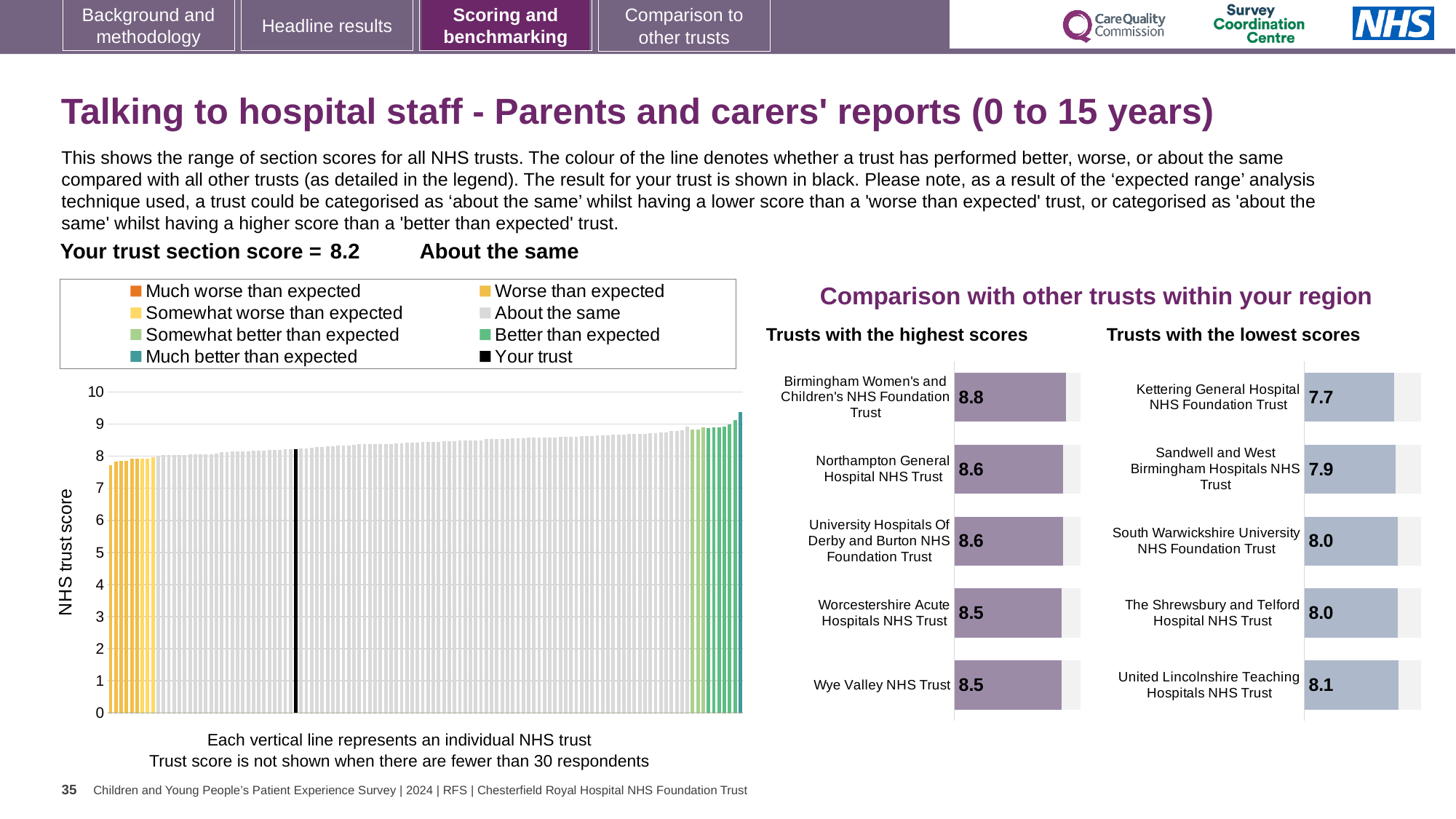
In the 'Trusts with the highest scores' chart, what is the score for Birmingham Women's and Children's NHS Foundation Trust? 8.8 In the 'Trusts with the highest scores' chart, which trust has the highest score? Birmingham Women's and Children's NHS Foundation Trust What kind of chart is the main chart showing the range of section scores for all NHS trusts? Bar chart How many entries does the legend of the main NHS trust score chart list? 8 In the 'Trusts with the lowest scores' chart, which has the higher score: Sandwell and West Birmingham Hospitals NHS Trust or United Lincolnshire Teaching Hospitals NHS Trust? United Lincolnshire Teaching Hospitals NHS Trust In the 'Trusts with the lowest scores' chart, which trust has the lowest score? Kettering General Hospital NHS Foundation Trust What is the label on the vertical axis of the main chart? NHS trust score In the 'Trusts with the highest scores' chart, what is the score for Worcestershire Acute Hospitals NHS Trust? 8.5 How many trusts are shown in the 'Trusts with the highest scores' chart? 5 In the 'Trusts with the lowest scores' chart, what is the score for Kettering General Hospital NHS Foundation Trust? 7.7 In the main NHS trust score chart, do the values rise or fall from left to right? Rise In the 'Trusts with the highest scores' chart, what is the difference between the scores of Birmingham Women's and Children's NHS Foundation Trust and Wye Valley NHS Trust? 0.3